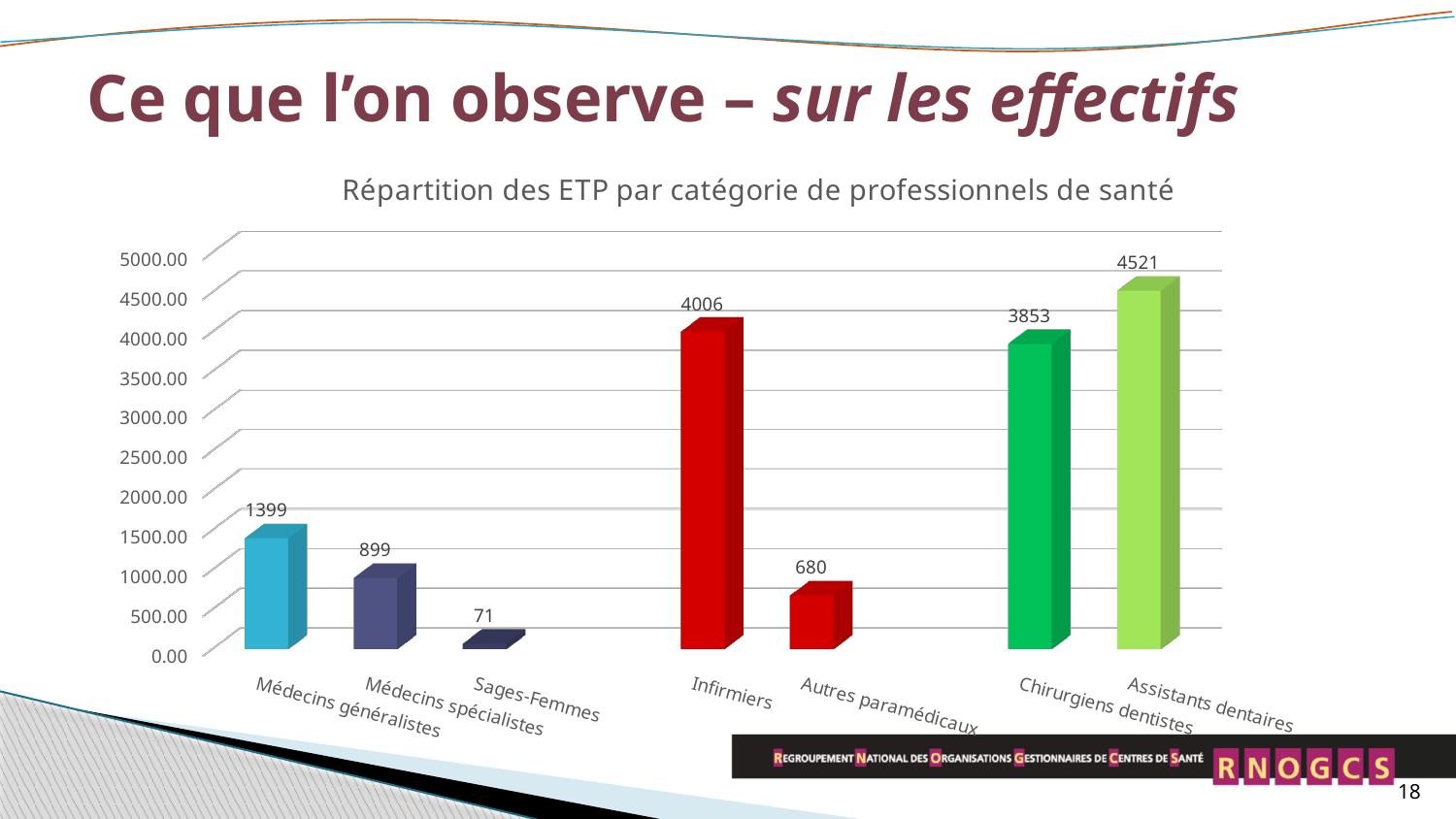
What is the difference between the values for Assistants dentaires and Infirmiers? 515 What is the value for Chirurgiens dentistes? 3853 Which category has the lowest value? Sages-Femmes Which is larger, the value for Infirmiers or the value for Chirurgiens dentistes? Infirmiers Is the value for Autres paramédicaux greater or less than 1000? less Which category has the highest value? Assistants dentaires What kind of chart is shown on the slide? bar chart How many categories are shown on the chart? 7 What is the value for Sages-Femmes? 71 What is the title of the chart? Répartition des ETP par catégorie de professionnels de santé What is the value for Infirmiers? 4006 What is the difference between the values for Médecins généralistes and Médecins spécialistes? 500